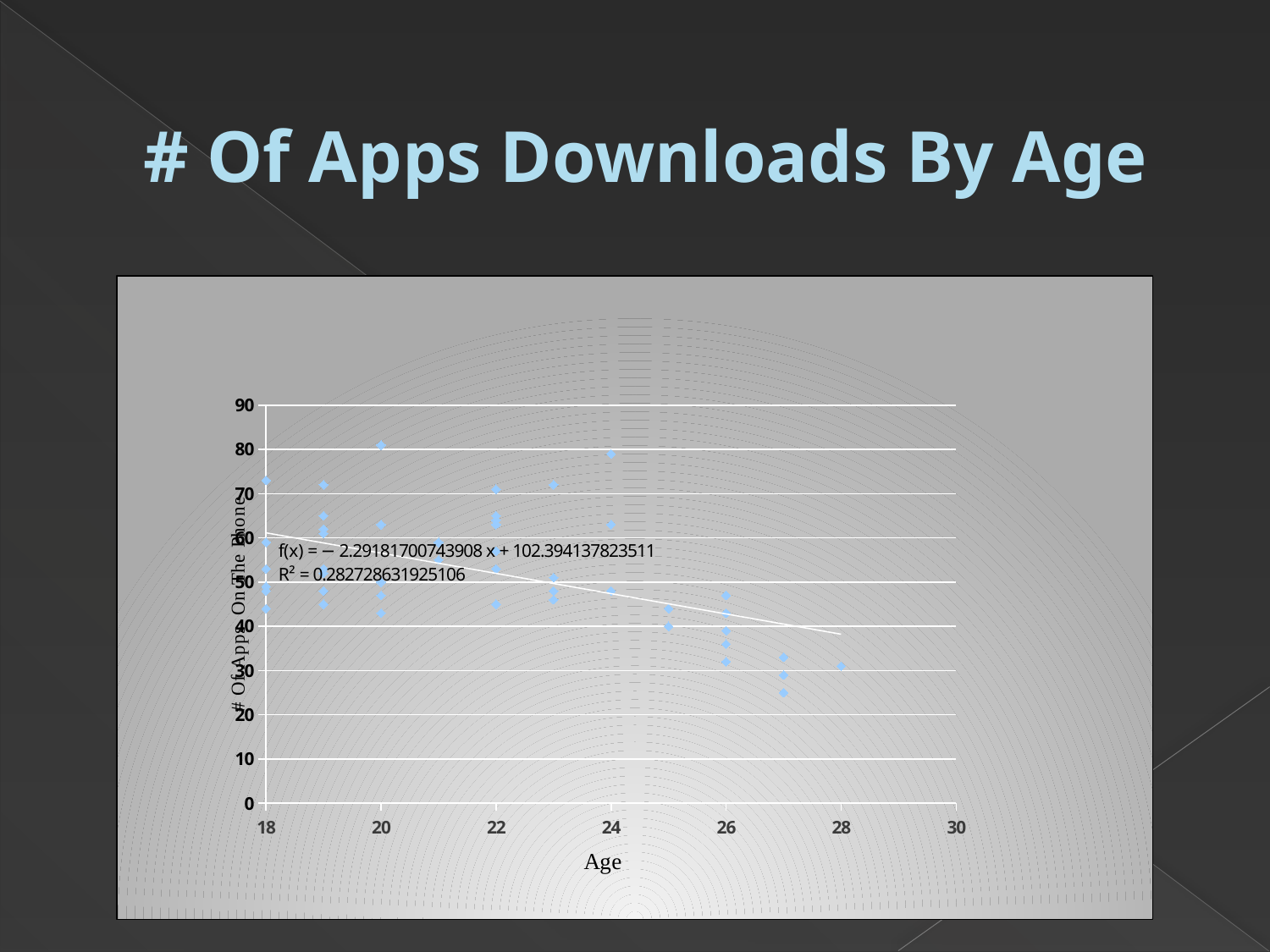
What is the label on the x axis of the chart? Age Is the lowest point at age 26 greater or less than 40? less Is the highest point at age 18 greater or less than 70? greater What is the title of the chart? # Of Apps Downloads By Age Is the lowest point at age 27 greater or less than 30? less Does the trendline rise or fall as age increases along the x axis? fall What kind of chart is shown on the slide? scatter chart What is the maximum value shown on the y axis of the chart? 90